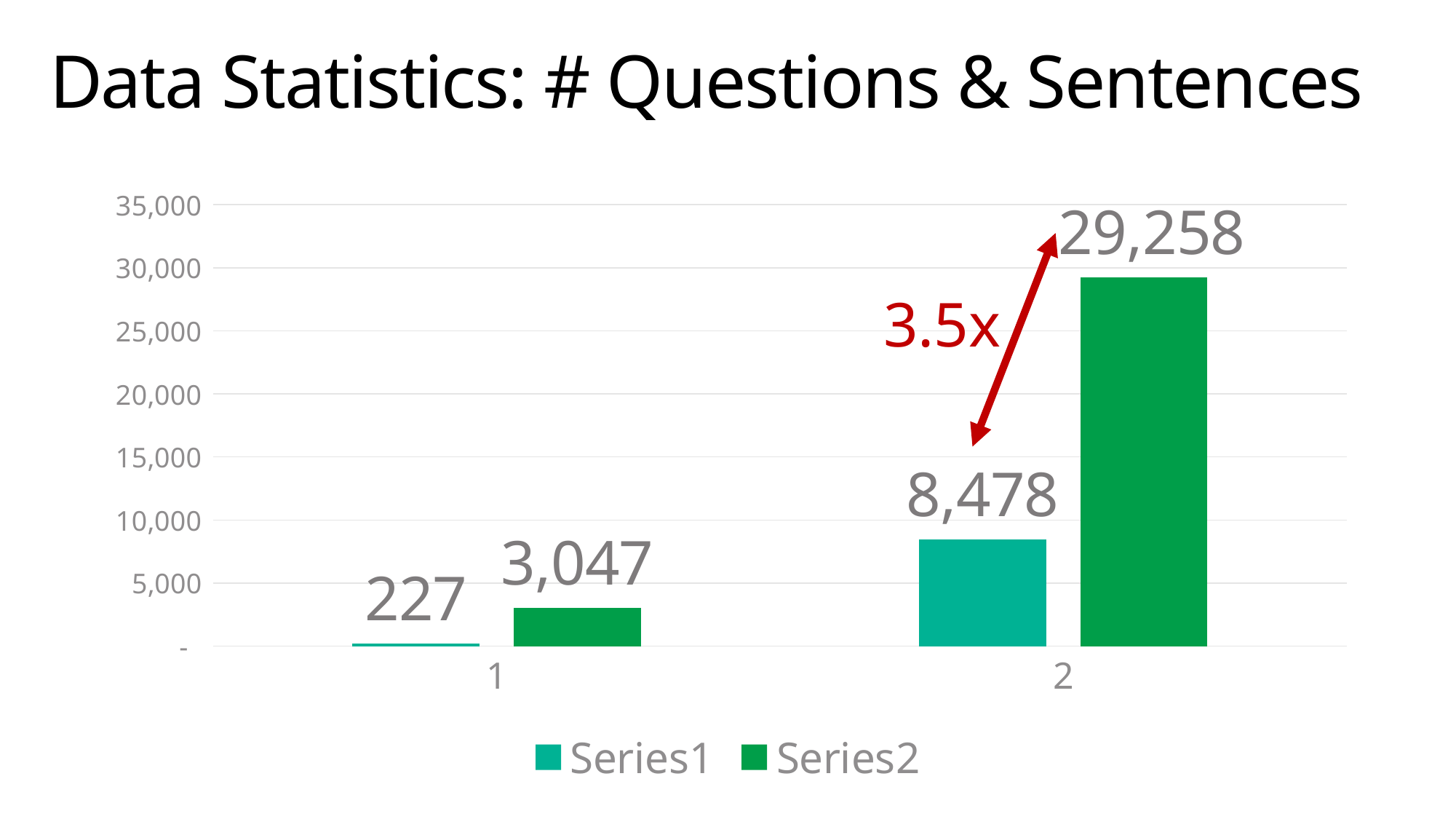
Which category has the lowest Series1 value? 1 How many series does the legend list? 2 What is the value of Series2 for category 1? 3,047 What kind of chart is shown on the slide? bar chart Which category has the highest Series2 value? 2 What is the value of Series2 for category 2? 29,258 What is the value of Series1 for category 1? 227 Which is larger: Series1 for category 2 or Series2 for category 1? Series1 for category 2 What is the value of Series1 for category 2? 8,478 How many categories are shown on the x axis? 2 Is the Series2 value for category 2 greater or less than 25,000? greater What is the difference between the Series2 and Series1 values for category 2? 20,780